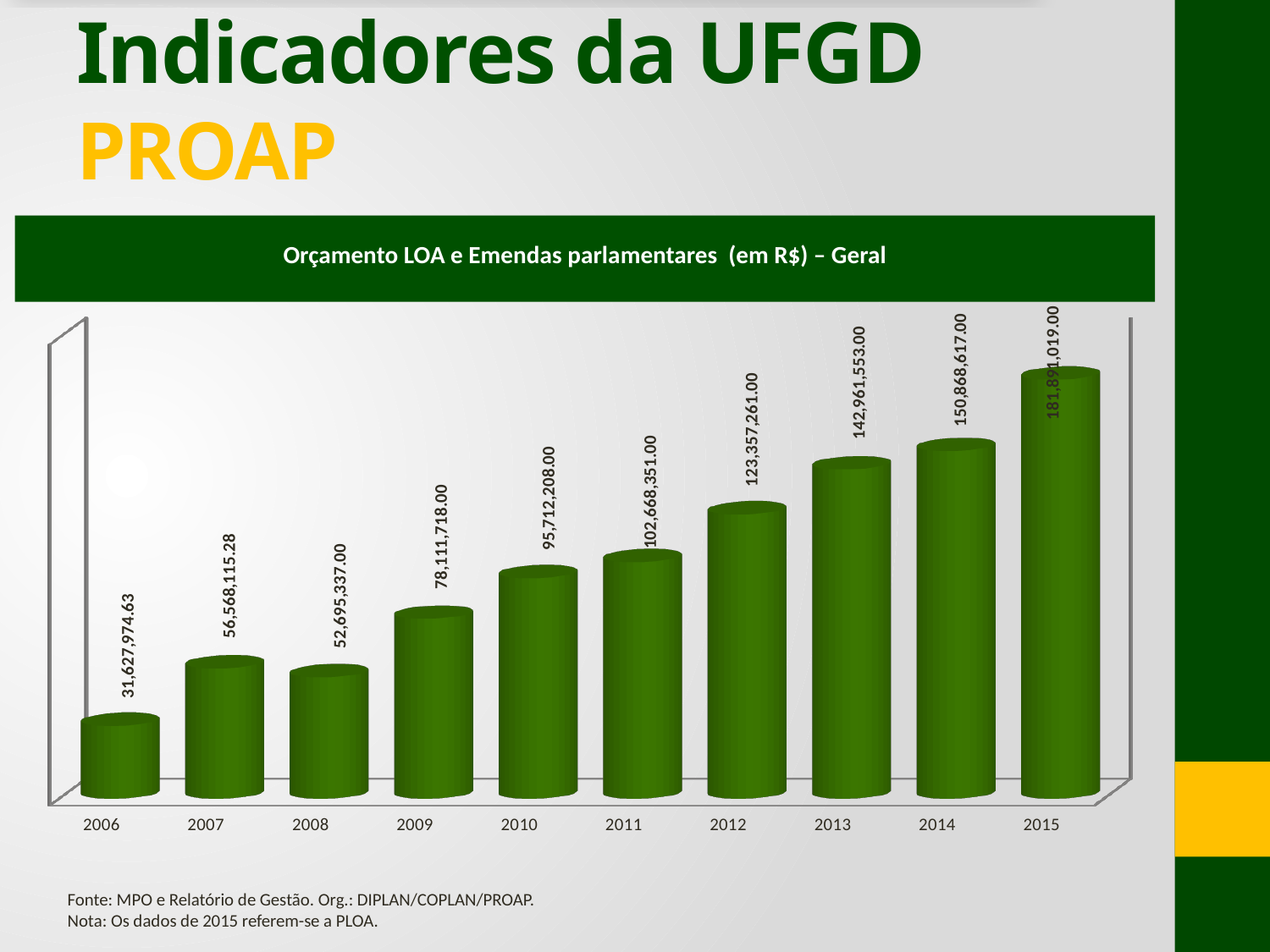
Which year has the highest value? 2015 What kind of chart is shown? Bar chart What is the value for 2010? 95,712,208.00 Which is larger, the value for 2007 or the value for 2008? 2007 Which year has the lowest value? 2006 What is the difference between the values for 2007 and 2008? 3,872,778.28 What is the difference between the values for 2014 and 2013? 7,907,064.00 What is the title of the chart? Orçamento LOA e Emendas parlamentares (em R$) – Geral What is the value for 2006? 31,627,974.63 How many years are shown on the x axis? 10 What is the value for 2013? 142,961,553.00 Do the values generally rise or fall from 2006 to 2015? Rise